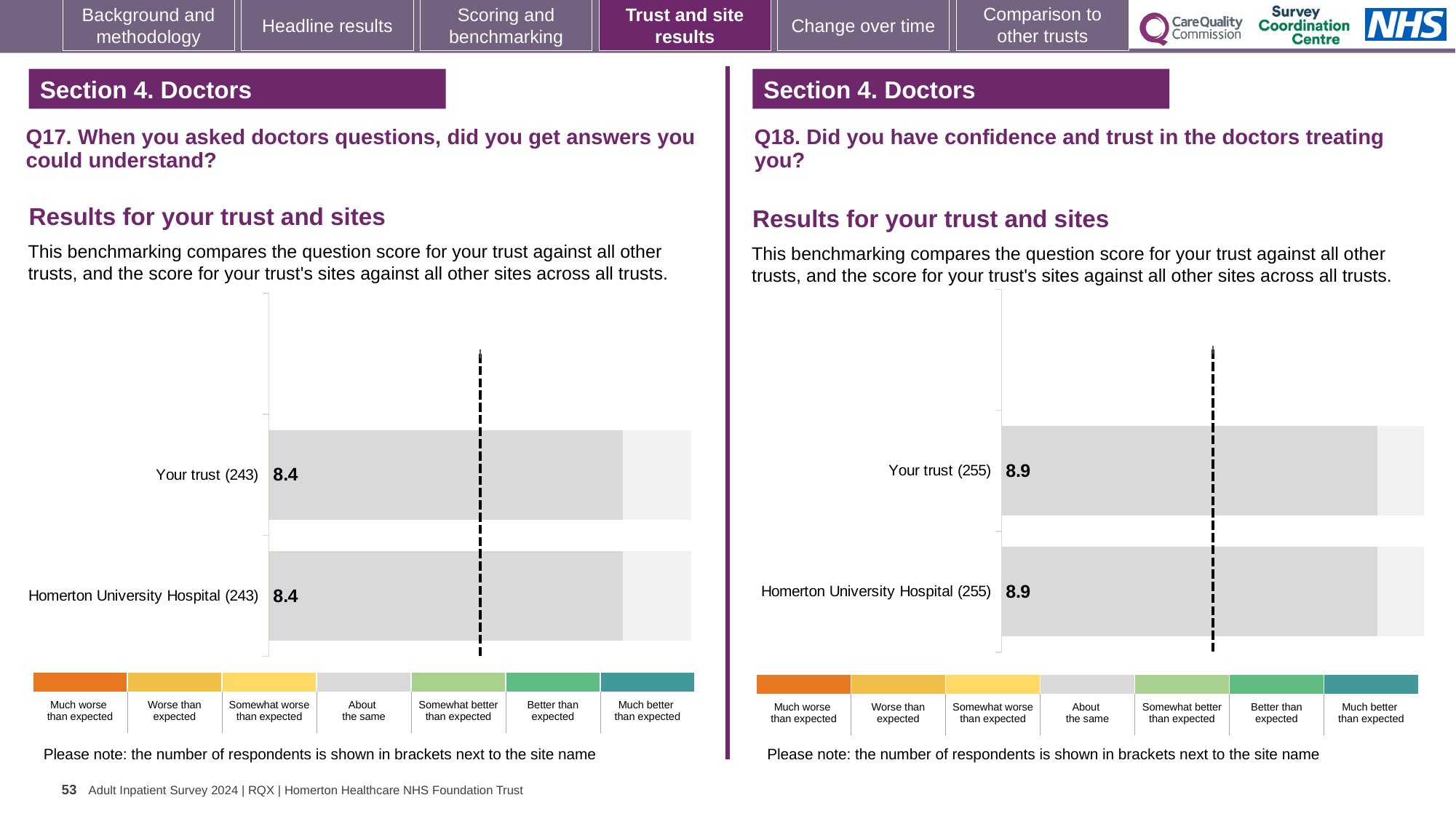
How many bars are plotted on the Q18 chart (right)? 2 On the Q17 chart (left), what is the score for Your trust? 8.4 On the Q18 chart (right), how many respondents are shown in brackets for Homerton University Hospital? 255 On the Q18 chart (right), what is the score for Homerton University Hospital? 8.9 On the Q17 chart (left), what is the difference between the score for Your trust and the score for Homerton University Hospital? 0 How many bars are plotted on the Q17 chart (left)? 2 On the Q17 chart (left), how many respondents are shown in brackets for Your trust? 243 What type of chart is used on the Q17 chart (left)? Bar chart On the Q18 chart (right), what is the difference between the score for Your trust and the score for Homerton University Hospital? 0 Is the score for Your trust on the Q18 chart (right) larger or smaller than the score for Your trust on the Q17 chart (left)? Larger On the Q17 chart (left), what is the score for Homerton University Hospital? 8.4 On the Q18 chart (right), what is the score for Your trust? 8.9